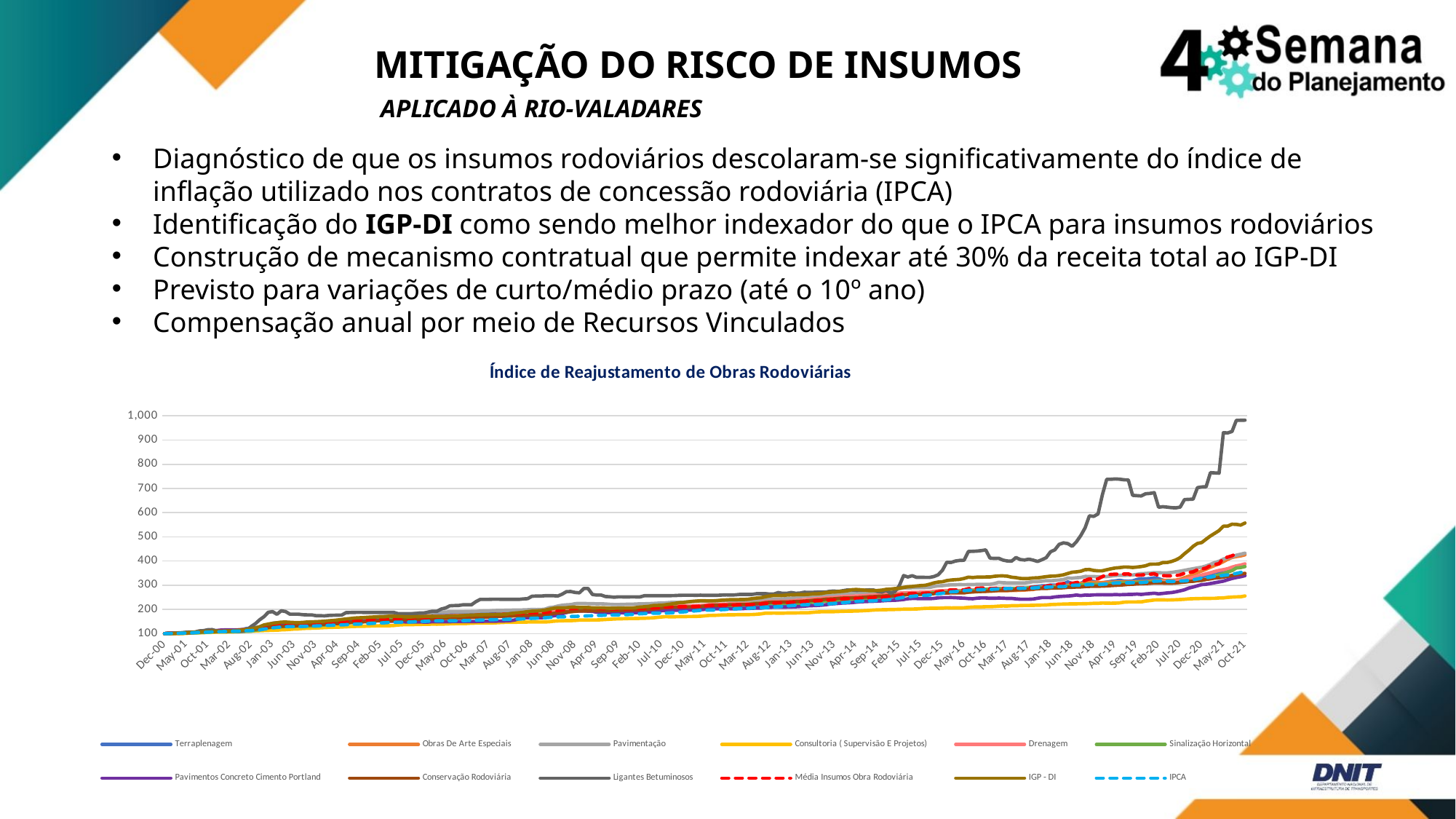
What kind of chart is shown on the slide? line chart Do the values of Ligantes Betuminosos generally rise or fall from Dec-00 to Oct-21? rise Is the value for Ligantes Betuminosos at Apr-19 greater or less than 700? greater Is the value for Ligantes Betuminosos at Oct-21 greater or less than 900? greater Is the value for Consultoria ( Supervisão E Projetos) at Oct-21 greater or less than 300? less What is the highest tick value shown on the y axis of the chart? 1,000 At Oct-21, which is larger: IGP - DI or IPCA? IGP - DI How many series does the legend of the chart list? 12 Which series reaches the highest value at the end of the chart (Oct-21)? Ligantes Betuminosos What is the title of the chart? Índice de Reajustamento de Obras Rodoviárias Which series has the lowest value at the end of the chart (Oct-21)? Consultoria ( Supervisão E Projetos)